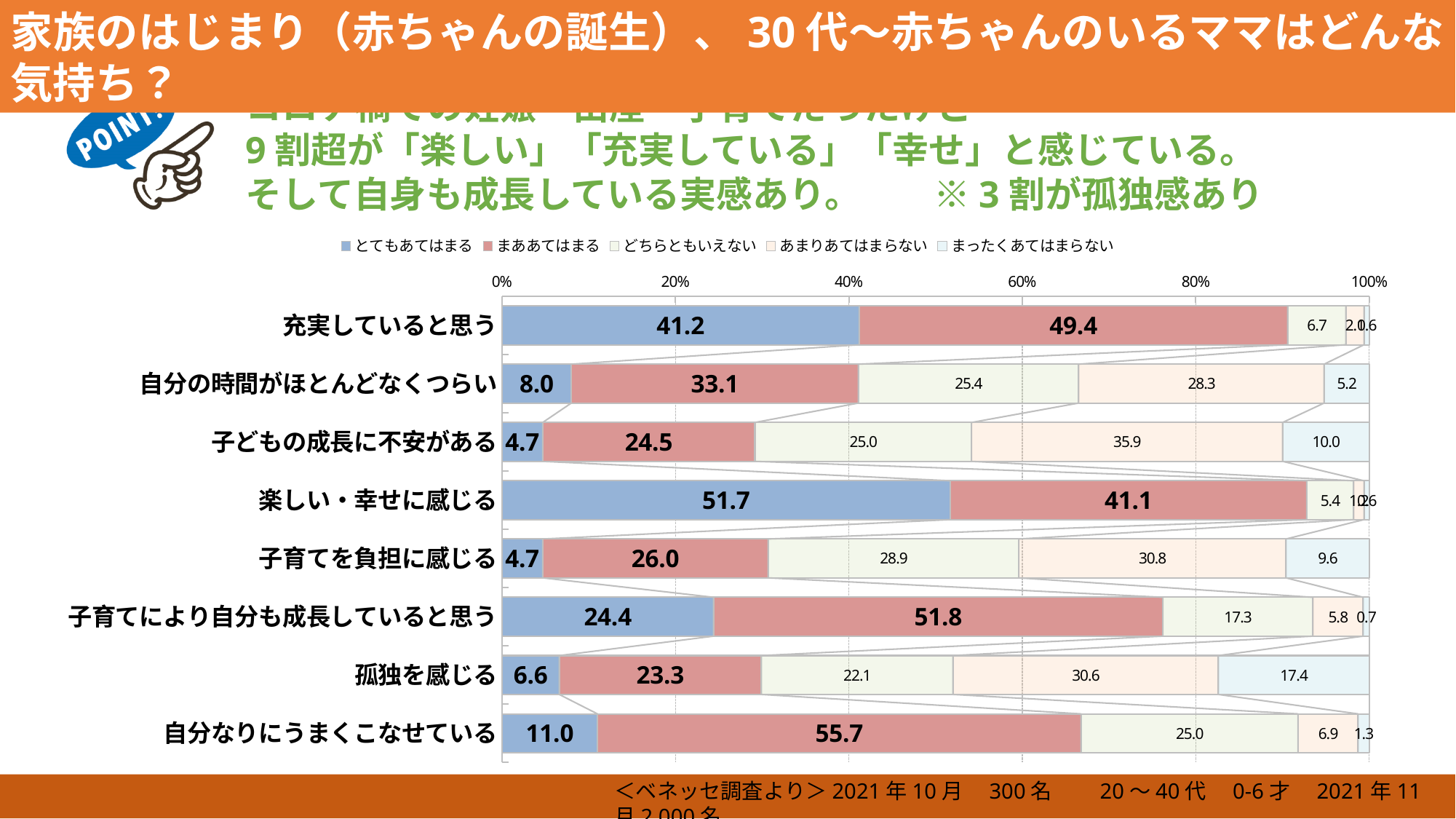
Which statement has the highest value for まったくあてはまらない? 孤独を感じる What is the value of まったくあてはまらない for 孤独を感じる? 17.4 What is the value of あまりあてはまらない for 子どもの成長に不安がある? 35.9 How many categories (statements) are plotted on the chart? 8 Which statement has the highest value for とてもあてはまる? 楽しい・幸せに感じる What is the difference between the とてもあてはまる values for 楽しい・幸せに感じる and 充実していると思う? 10.5 What kind of chart is shown on the slide? Stacked bar chart What is the value of とてもあてはまる for 楽しい・幸せに感じる? 51.7 How many series does the legend list? 5